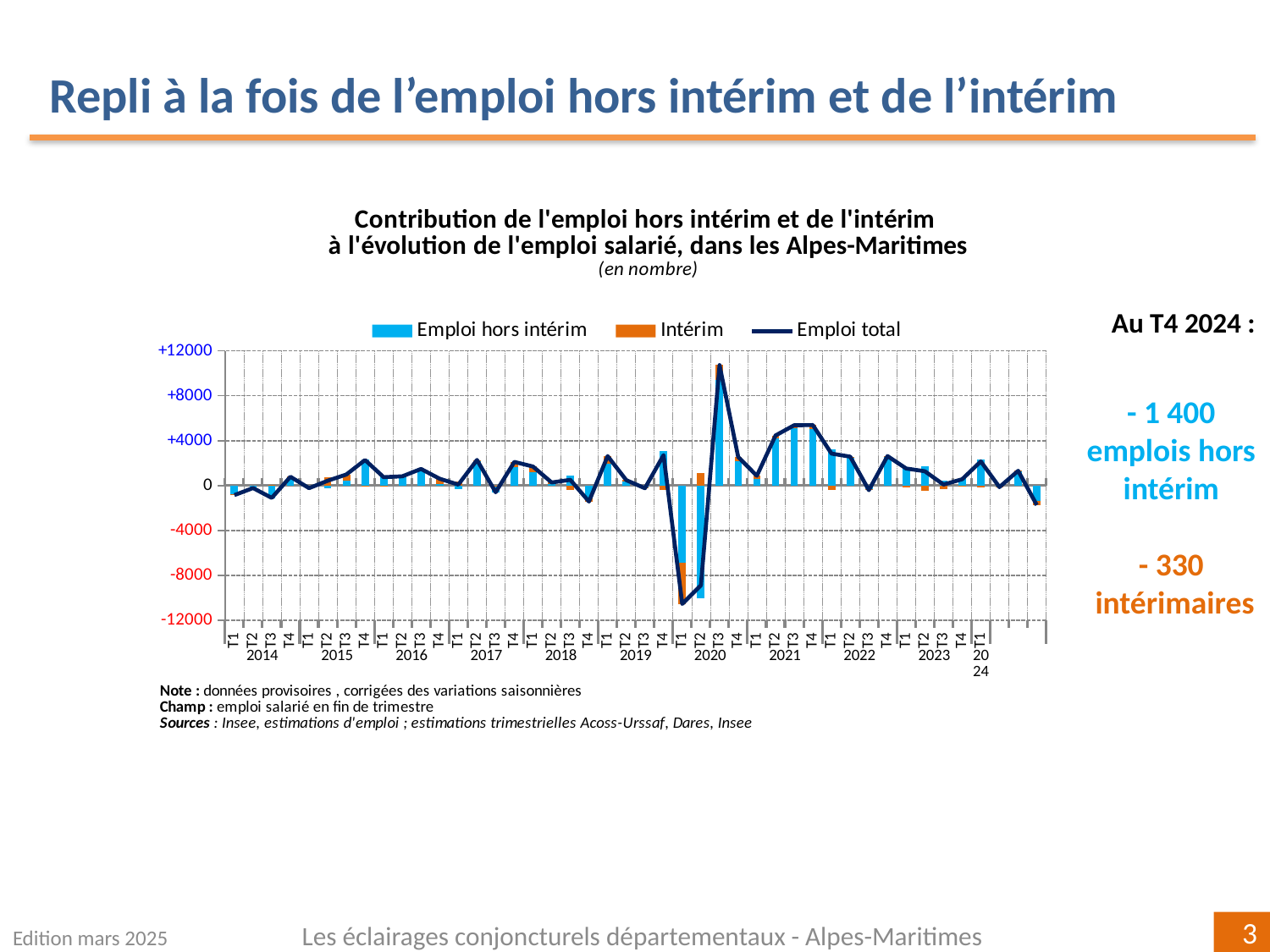
According to the slide, what is the value for Intérim at T4 2024? - 330 In which quarter does the Emploi total line reach its highest point? T3 2020 Is the Emploi hors intérim value for T3 2021 greater or less than +4000? greater Which is larger, the Emploi hors intérim value for T3 2020 or for T1 2020? T3 2020 How many series does the chart legend list? 3 Is the Emploi hors intérim value for T3 2020 greater or less than +8000? greater What kind of chart is shown on the slide? Combined bar and line chart Is the Emploi hors intérim value for T1 2020 greater or less than -8000? greater Does the Emploi total line rise or fall between T1 2020 and T3 2020? rise According to the slide, what is the value for Emploi hors intérim at T4 2024? - 1 400 What is the title of the chart? Contribution de l'emploi hors intérim et de l'intérim à l'évolution de l'emploi salarié, dans les Alpes-Maritimes In which quarter does the Emploi total line reach its lowest point? T1 2020